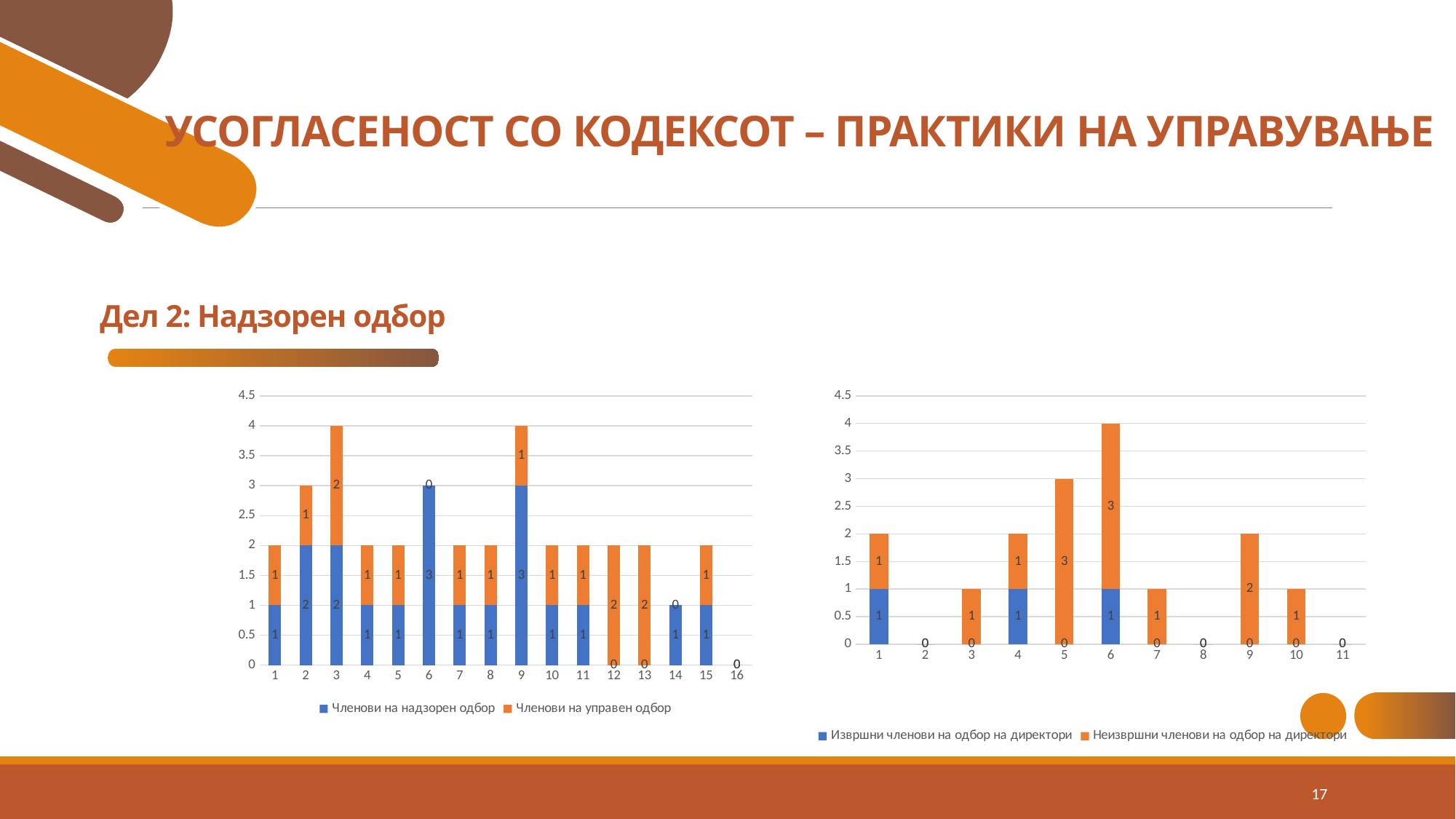
In the right chart, what is the value of Неизвршни членови на одбор на директори for category 5? 3 In the left chart, what is the value of Членови на надзорен одбор for category 6? 3 In the left chart, what is the difference between the Членови на надзорен одбор values for category 6 and category 14? 2 In the left chart, how many series does the legend list? 2 In the right chart, how many categories are shown on the x axis? 11 In the right chart, which is larger: the Неизвршни членови на одбор на директори value for category 9 or for category 10? Category 9 In the left chart, how many categories are shown on the x axis? 16 In the left chart, what is the value of Членови на управен одбор for category 3? 2 What kind of chart is the left chart on the slide? Stacked bar chart In the right chart, which category has the highest total stacked bar? 6 In the left chart, what is the total of the stacked bar for category 9? 4 In the right chart, what is the total of the stacked bar for category 6? 4